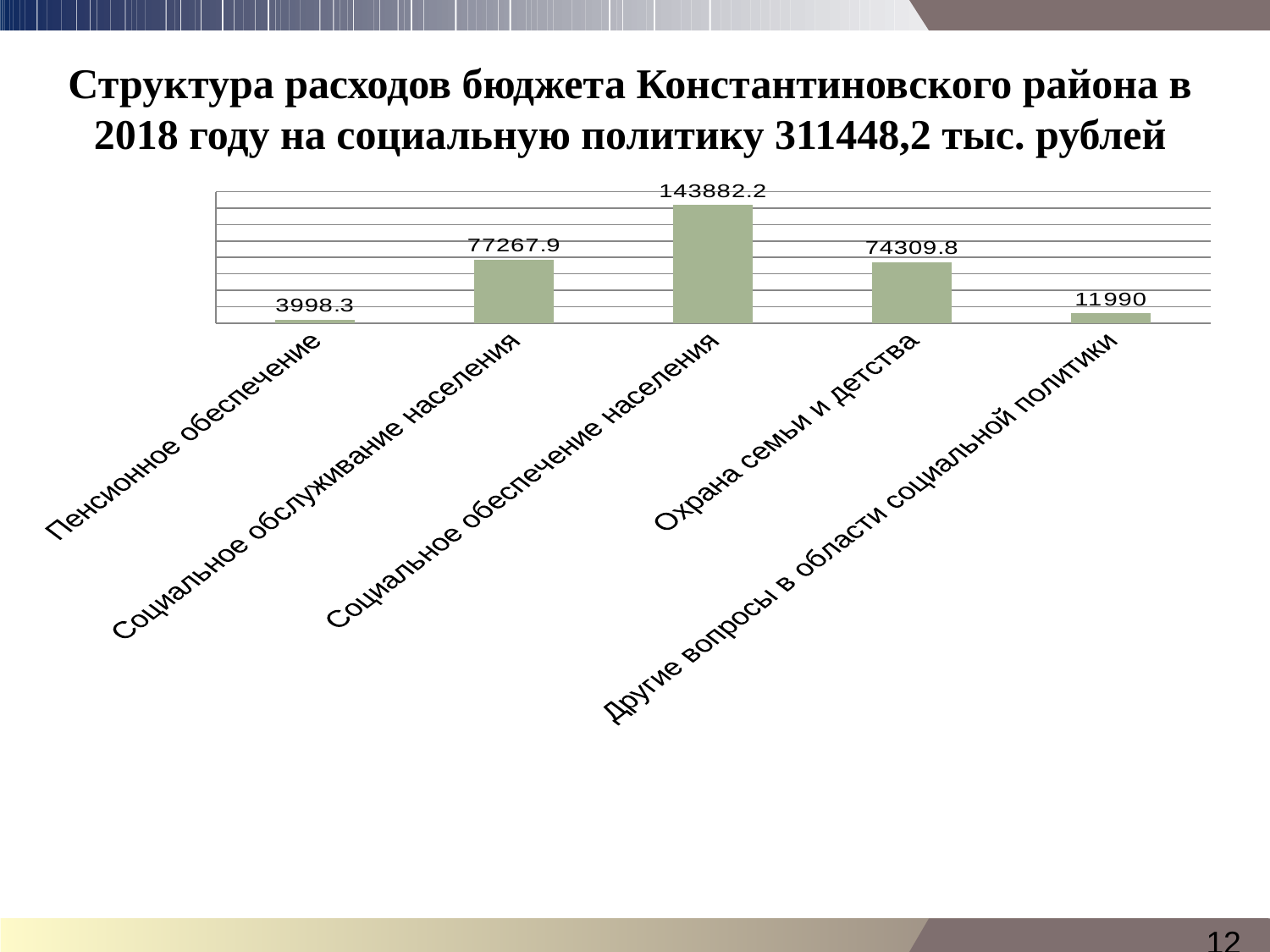
How many categories are shown in the chart? 5 What is the value for Социальное обеспечение населения? 143882.2 What kind of chart is shown on the slide? Bar chart Which category has the highest value? Социальное обеспечение населения What is the value for Социальное обслуживание населения? 77267.9 What is the value for Пенсионное обеспечение? 3998.3 What is the value for Другие вопросы в области социальной политики? 11990 Which is larger, the value for Охрана семьи и детства or the value for Другие вопросы в области социальной политики? Охрана семьи и детства What is the difference between the values for Другие вопросы в области социальной политики and Пенсионное обеспечение? 7991.7 What is the difference between the values for Социальное обеспечение населения and Социальное обслуживание населения? 66614.3 What is the value for Охрана семьи и детства? 74309.8 Which category has the lowest value? Пенсионное обеспечение